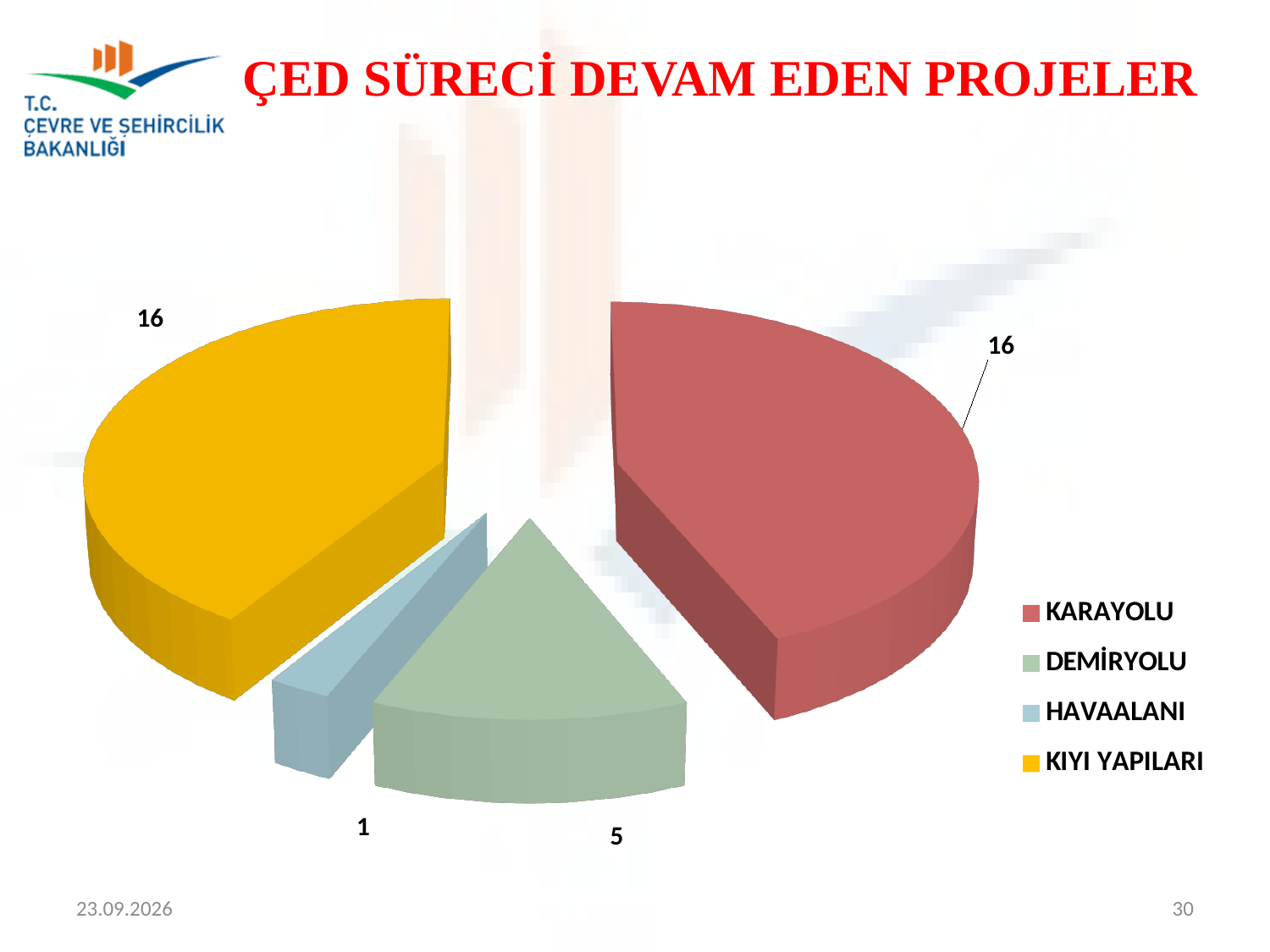
Which category has the lowest value? HAVAALANI What is the value for DEMİRYOLU? 5 What is the difference between the values for DEMİRYOLU and HAVAALANI? 4 How many categories does the pie chart have? 4 What is the value for KARAYOLU? 16 What is the total of all slices in the pie chart? 38 What type of chart is shown on the slide? pie chart What is the value for HAVAALANI? 1 What is the value for KIYI YAPILARI? 16 What is the title of the slide containing the chart? ÇED SÜRECİ DEVAM EDEN PROJELER Which is larger, the value for DEMİRYOLU or the value for HAVAALANI? DEMİRYOLU What is the difference between the values for KARAYOLU and DEMİRYOLU? 11